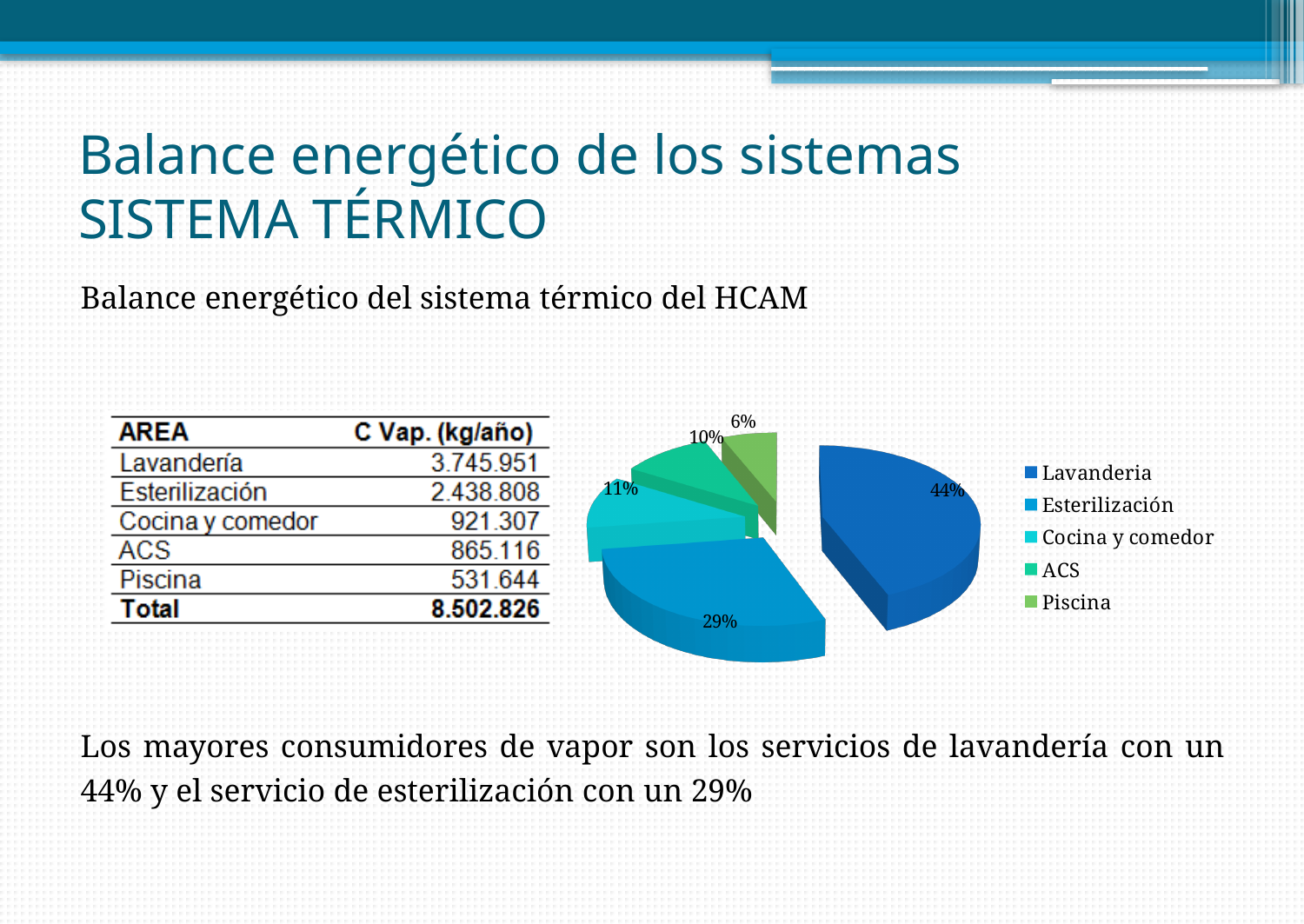
Which category has the smallest slice of the pie? Piscina What share of the pie does Piscina have? 6% What share of the pie does Cocina y comedor have? 11% What share of the pie does ACS have? 10% What is the difference in percentage points between the Lavanderia slice and the Esterilización slice? 15% How many categories does the pie chart show? 5 Which is larger, the slice for Esterilización or the slice for Cocina y comedor? Esterilización How many entries does the legend of the pie chart list? 5 Which category has the largest slice of the pie? Lavanderia What kind of chart is shown on the slide? pie chart